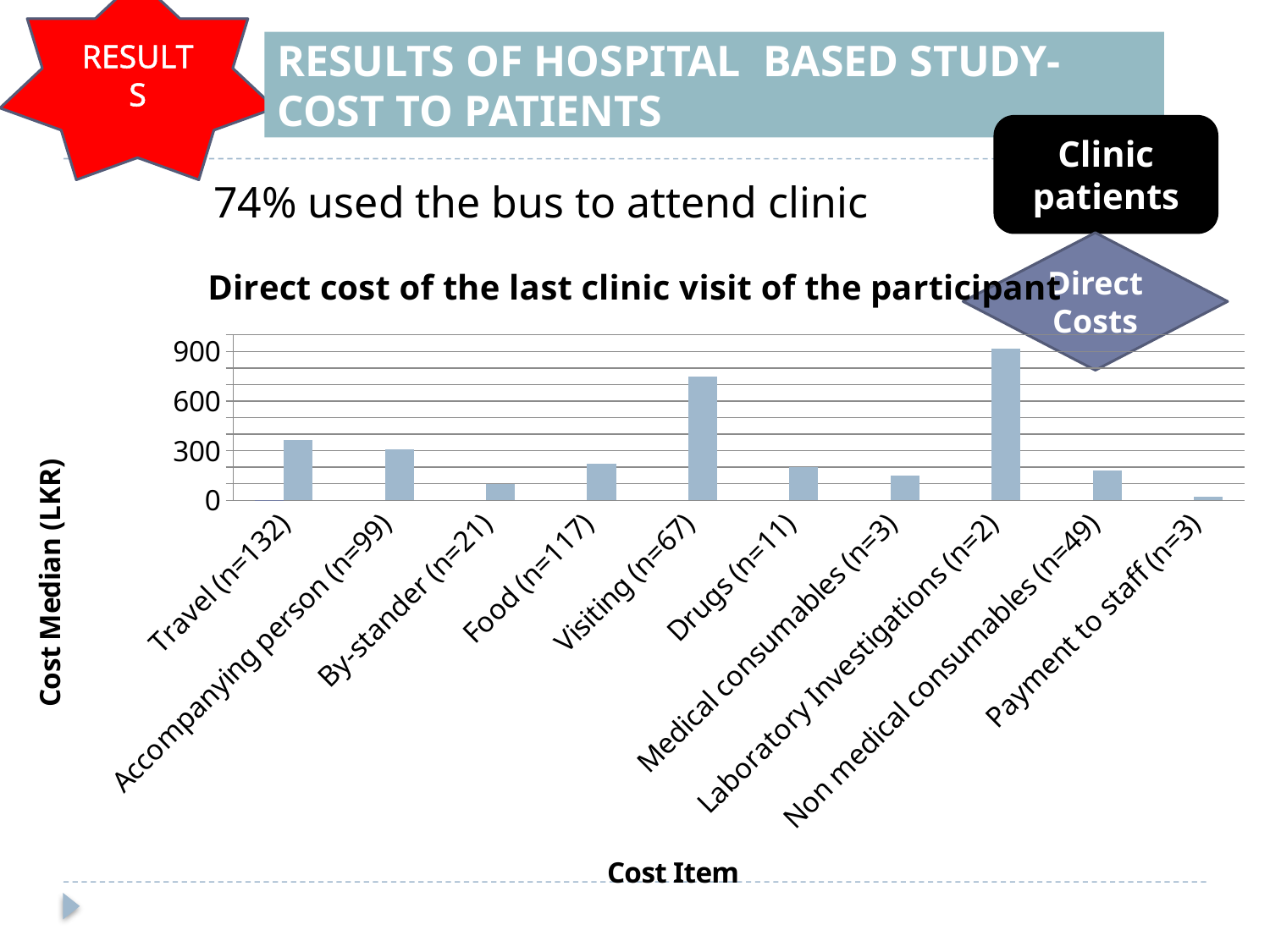
Is the value for Visiting (n=67) greater or less than 600? greater Is the value for By-stander (n=21) greater or less than 300? less What kind of chart is shown on the slide? bar chart How many cost items are plotted on the chart? 10 Is the value for Travel (n=132) greater or less than 300? greater Which has a higher median cost, Visiting (n=67) or Travel (n=132)? Visiting (n=67) Which has a higher median cost, Travel (n=132) or Food (n=117)? Travel (n=132) What is the title of the chart? Direct cost of the last clinic visit of the participant What is the label of the vertical axis? Cost Median (LKR) Which cost item has the lowest median cost? Payment to staff (n=3) Which cost item has the highest median cost? Laboratory Investigations (n=2)